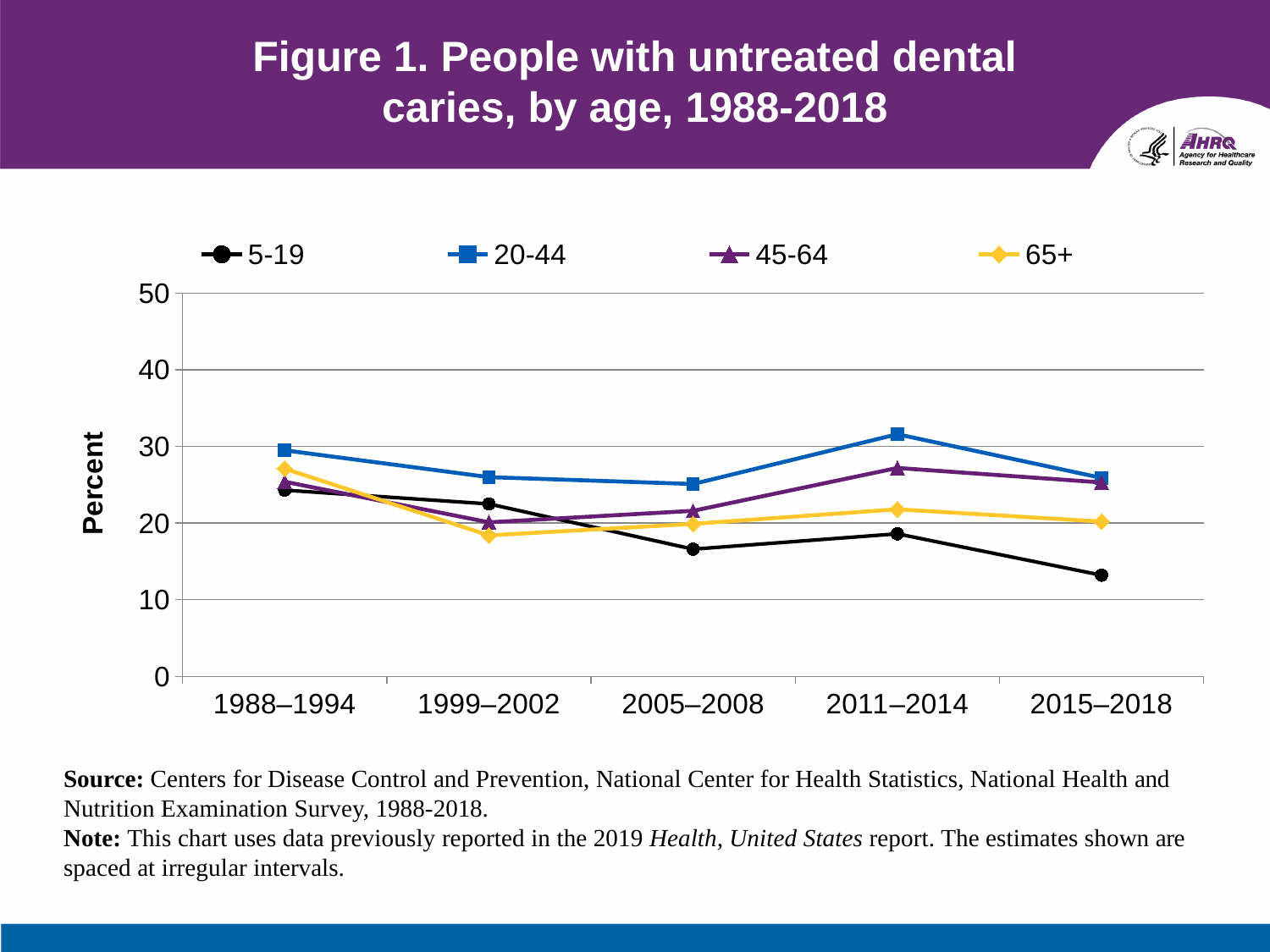
Does the value for the 5-19 age group rise or fall from 1988–1994 to 2015–2018? fall What kind of chart is shown on the slide? line chart Which age group has the lowest percentage in 2015–2018? 5-19 Which age group has the highest percentage in 2011–2014? 20-44 What is the label on the y axis? Percent In 2015–2018, which age group has the larger value, 45-64 or 65+? 45-64 Is the value for the 20-44 age group in 2011–2014 greater or less than 30? greater Is the value for the 65+ age group in 1988–1994 greater or less than 20? greater How many time periods are shown on the x axis? 5 How many age groups does the legend list? 4 Is the value for the 5-19 age group in 2015–2018 greater or less than 20? less In 1988–1994, which age group has the larger value, 20-44 or 5-19? 20-44